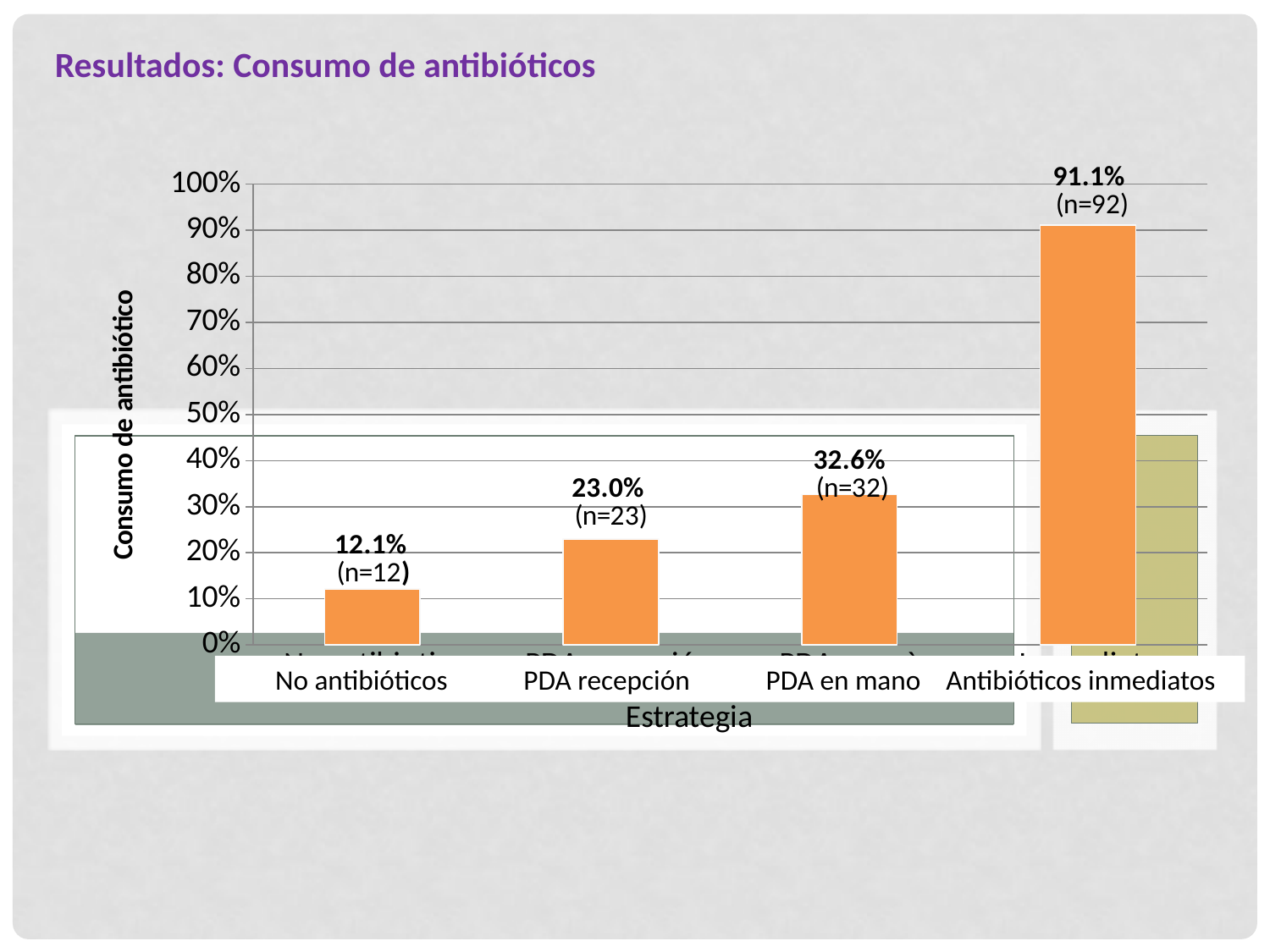
What is the difference in percentage points between 'PDA en mano' and 'PDA recepción'? 9.6 percentage points What is the difference in percentage points between 'Antibióticos inmediatos' and 'No antibióticos'? 79.0 percentage points Which strategy has the lowest antibiotic consumption? No antibióticos What is the n value printed above the 'PDA en mano' bar? n=32 What is the label of the x axis of the chart? Estrategia What is the antibiotic consumption value shown for 'Antibióticos inmediatos'? 91.1% What kind of chart is shown on the slide? Bar chart What is the antibiotic consumption value shown for 'PDA recepción'? 23.0% Which strategy has the highest antibiotic consumption? Antibióticos inmediatos Which has a higher antibiotic consumption, 'PDA recepción' or 'PDA en mano'? PDA en mano Is the value for 'Antibióticos inmediatos' greater or less than 80%? greater How many strategies (categories) are shown on the x axis? 4